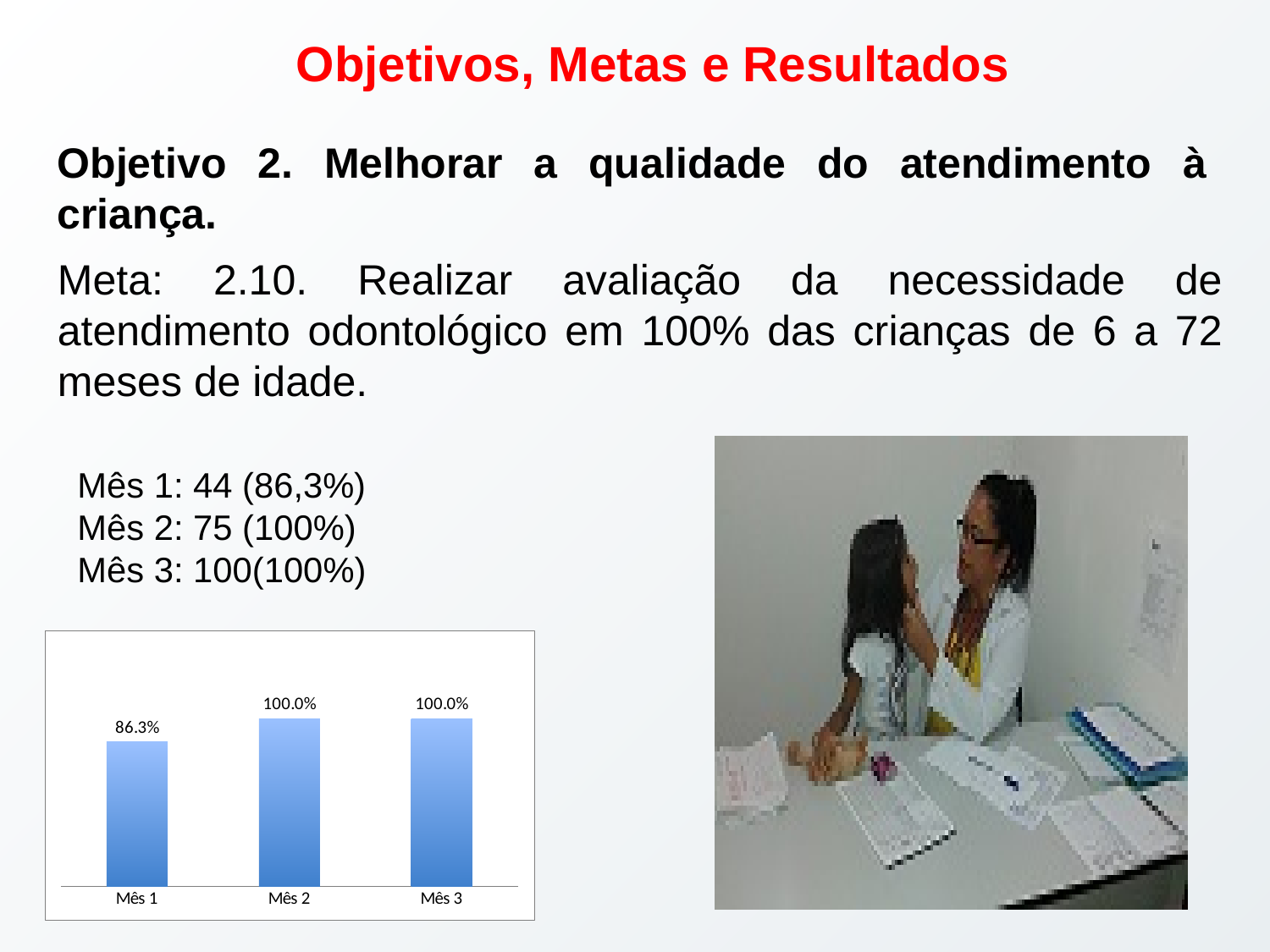
What is the difference between the values for Mês 2 and Mês 1? 13.7% How many categories are shown on the x axis of the chart? 3 What is the value for Mês 3 in the chart? 100.0% Do the values rise or fall from Mês 1 to Mês 2? Rise What is the value for Mês 2 in the chart? 100.0% What kind of chart is shown on the slide? Bar chart Does the chart have a title? No Which category has the lowest value in the chart? Mês 1 Which is larger, the value for Mês 1 or the value for Mês 3? Mês 3 Do the values change between Mês 2 and Mês 3? No, both are 100.0% What is the value for Mês 1 in the chart? 86.3% What colour are the bars in the chart? Blue